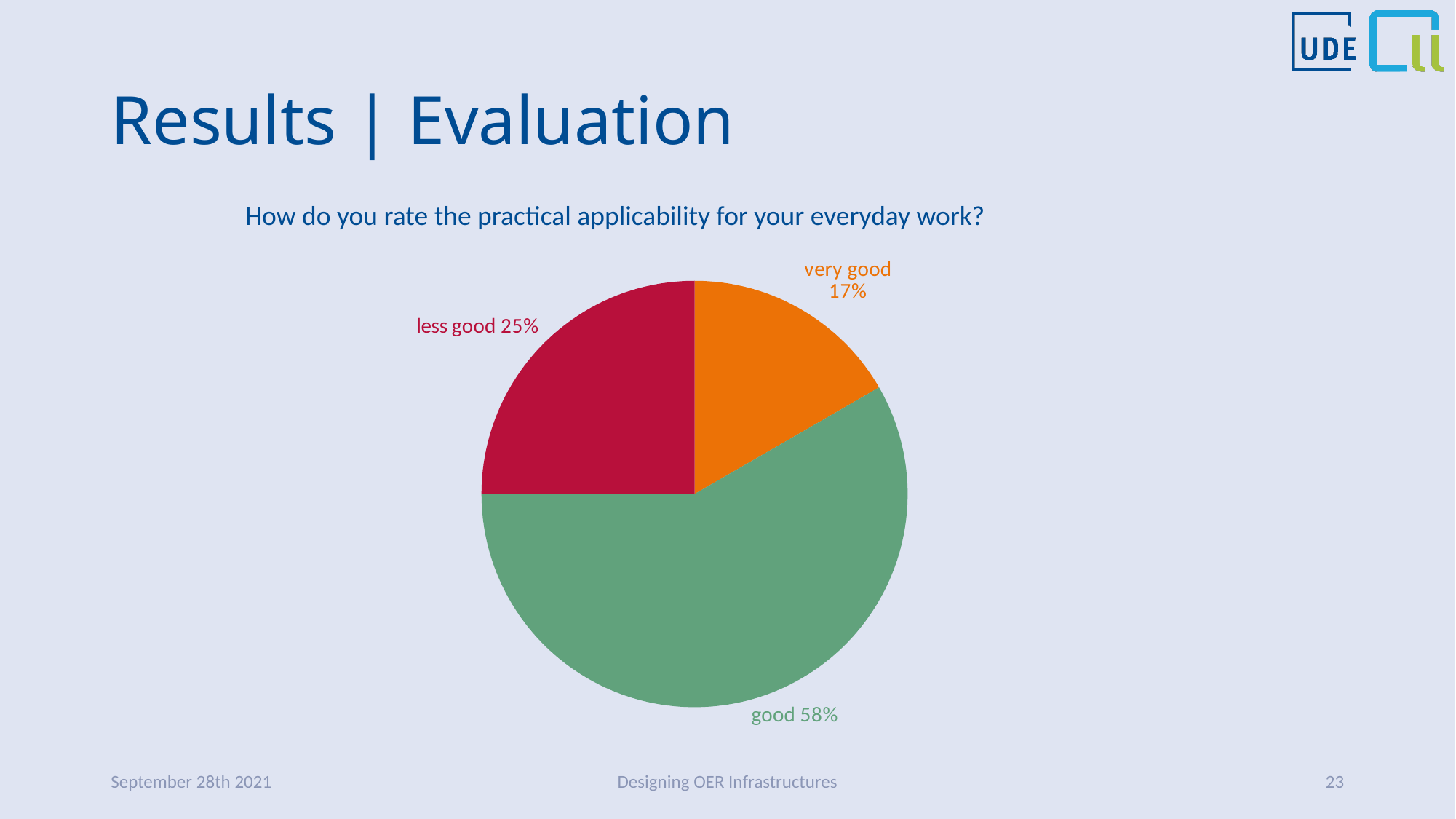
Which is larger, the share for "less good" or the share for "very good"? less good What kind of chart is shown on the slide? pie chart Which rating category has the largest share of the pie? good Which rating category has the smallest share of the pie? very good What colour is the "good" slice of the pie? green What is the difference in percentage points between the "less good" and "very good" shares? 8 How many categories are shown in the pie chart? 3 What share of respondents rated the practical applicability as "good"? 58% What share of respondents rated the practical applicability as "less good"? 25% What share of respondents rated the practical applicability as "very good"? 17% What is the difference in percentage points between the "good" and "less good" shares? 33 What is the chart's title? How do you rate the practical applicability for your everyday work?